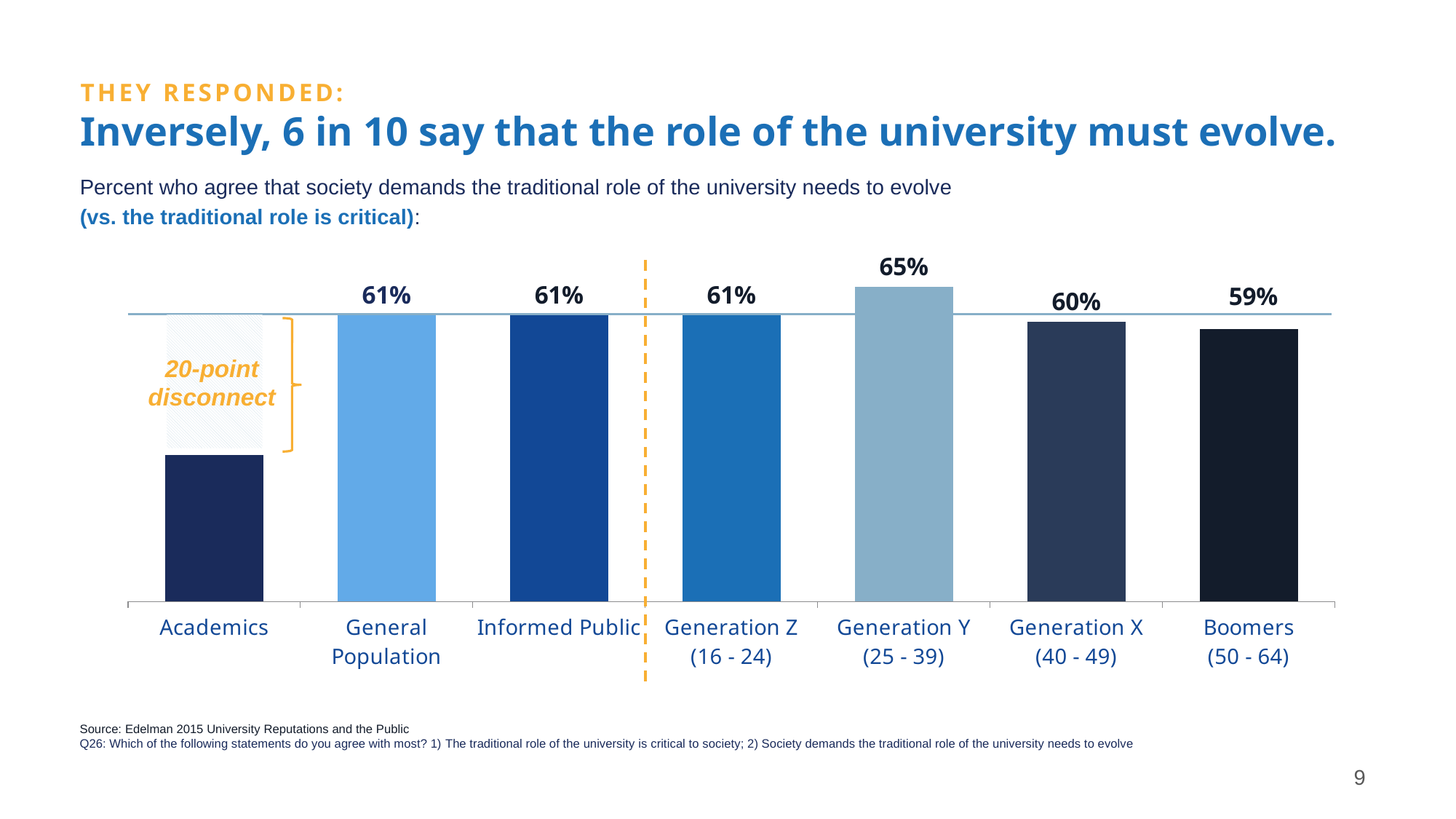
What is the difference in percentage points between Generation Y and Boomers? 6 percentage points What is the source cited for the chart? Edelman 2015 University Reputations and the Public Which is larger, the value for Academics or the value for General Population? General Population What kind of chart is shown on the slide? Bar chart How many categories are shown in the chart? 7 Which category has the highest value in the chart? Generation Y (25 - 39) What percentage of the General Population agree that the traditional role of the university needs to evolve? 61% What is the value shown for Boomers (50 - 64)? 59% What is the value shown for Generation Y (25 - 39)? 65% Which category has the lowest bar in the chart? Academics What does the orange annotation next to the Academics bar say? 20-point disconnect What is the value shown for Generation X (40 - 49)? 60%